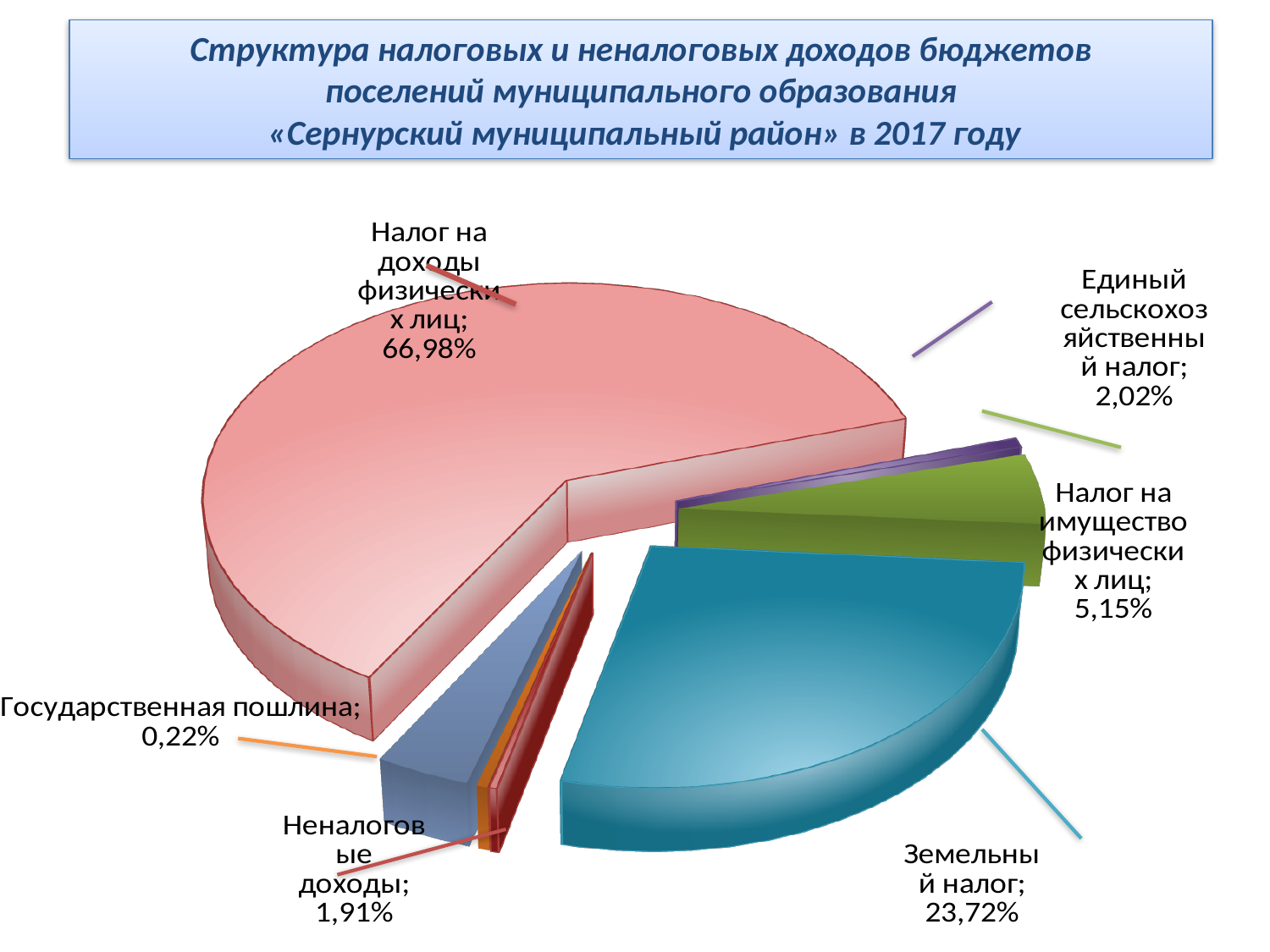
What is the value shown for Единый сельскохозяйственный налог? 2,02% What is the value shown for Земельный налог? 23,72% What is the difference between the shares of Налог на доходы физических лиц and Земельный налог? 43,26% Which category has the largest share of the pie? Налог на доходы физических лиц What is the value shown for Государственная пошлина? 0,22% What kind of chart is shown on the slide? Pie chart Which is larger, Неналоговые доходы or Единый сельскохозяйственный налог? Единый сельскохозяйственный налог Which category has the smallest share of the pie? Государственная пошлина What is the value shown for Налог на имущество физических лиц? 5,15% What share of the pie does Налог на доходы физических лиц have? 66,98% How many slices does the pie chart have? 7 What is the difference between the shares of Налог на имущество физических лиц and Единый сельскохозяйственный налог? 3,13%